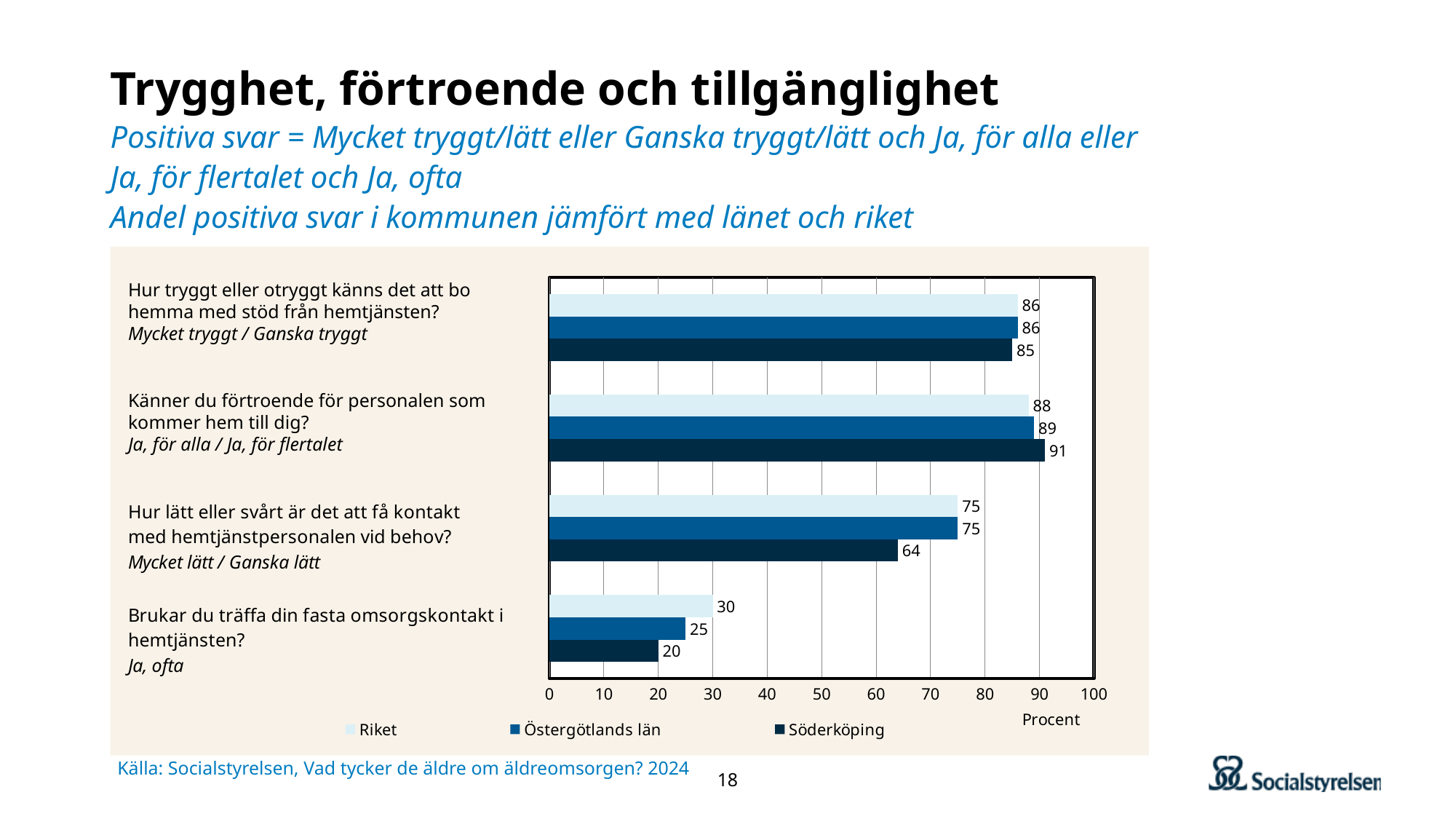
On the question "Brukar du träffa din fasta omsorgskontakt i hemtjänsten?", which is larger: Riket or Söderköping? Riket What is the difference between Riket and Söderköping on the question "Hur lätt eller svårt är det att få kontakt med hemtjänstpersonalen vid behov?"? 11 Is the value for Söderköping on the question "Hur tryggt eller otryggt känns det att bo hemma med stöd från hemtjänsten?" greater or less than 80? greater Which question has the highest value for Riket? Känner du förtroende för personalen som kommer hem till dig? What is the label of the x axis? Procent What is the value for Östergötlands län on the question "Hur lätt eller svårt är det att få kontakt med hemtjänstpersonalen vid behov?"? 75 What is the value for Söderköping on the question "Känner du förtroende för personalen som kommer hem till dig?"? 91 How many series does the legend list? 3 What kind of chart is shown on the slide? Bar chart Which question has the lowest value for Söderköping? Brukar du träffa din fasta omsorgskontakt i hemtjänsten? What is the value for Riket on the question "Brukar du träffa din fasta omsorgskontakt i hemtjänsten?"? 30 How many questions (categories) are shown in the chart? 4